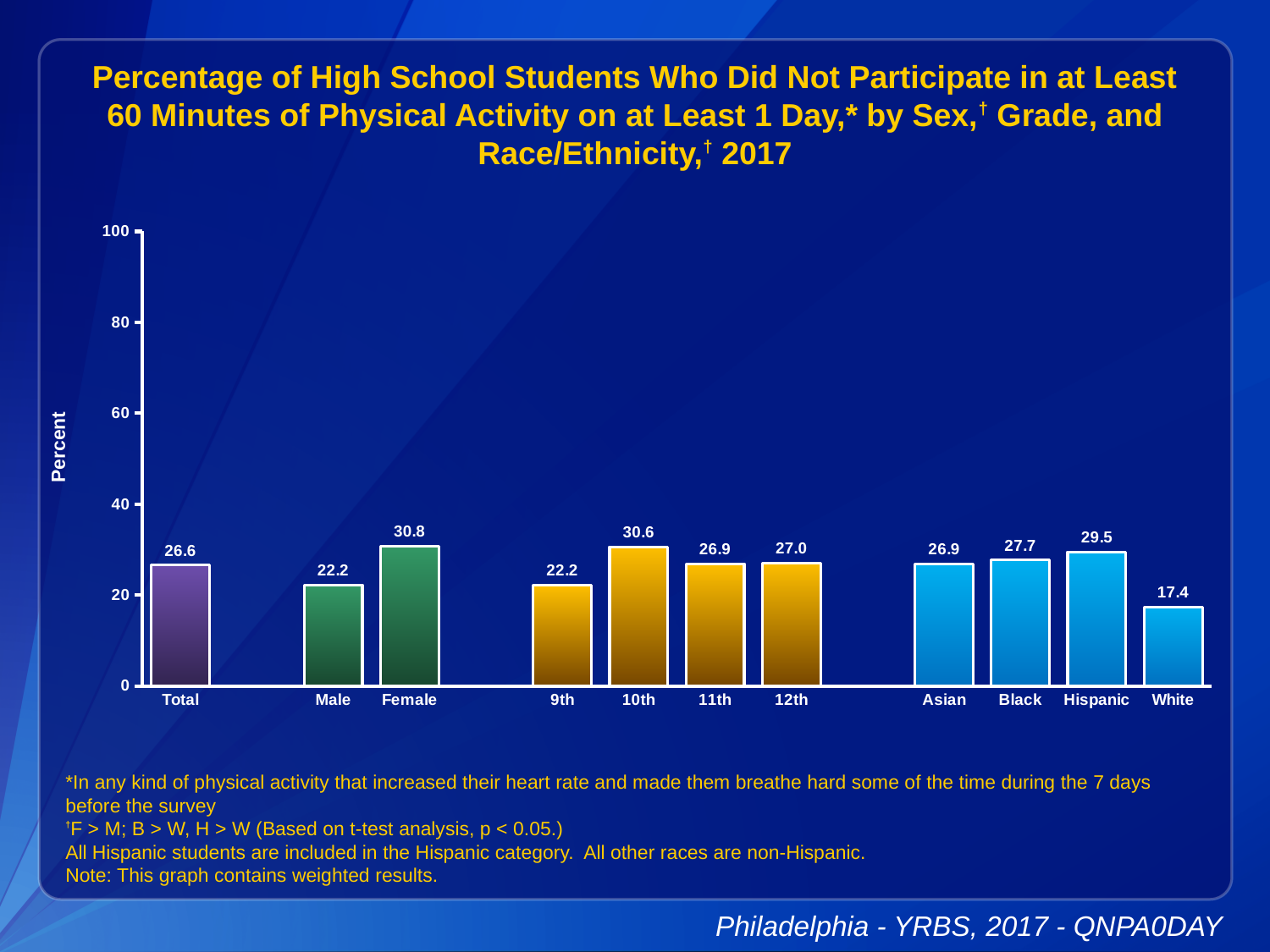
Which category has the highest value? Female What is the value for White? 17.4 How many categories are shown on the x axis? 11 What is the difference between the Hispanic and White values? 12.1 Which category has the lowest value? White What is the value for Total? 26.6 What is the difference between the Female and Male values? 8.6 What is the value for Female? 30.8 Which is larger, the value for Hispanic or the value for Black? Hispanic What is the label of the y axis? Percent What kind of chart is shown? bar chart Is the value for 10th grade greater or less than 40? less